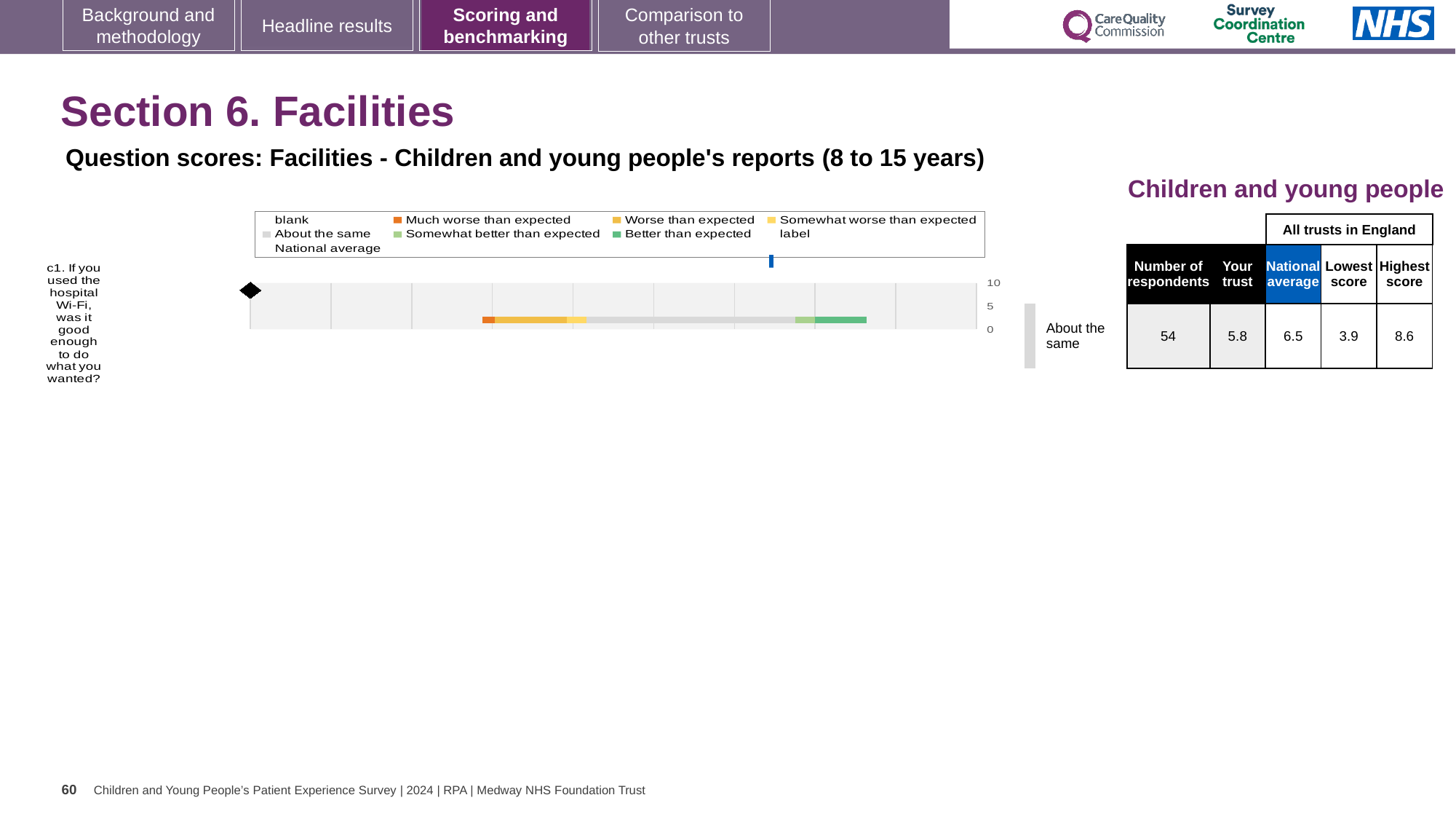
According to the table beside the chart, what is the lowest score among all trusts in England for question c1? 3.9 What is the difference between the highest score and the lowest score for question c1? 4.7 Which is larger for question c1: the 'Your trust' score or the national average? National average How many respondents answered question c1 about hospital Wi-Fi? 54 What kind of chart is used to show the question score for c1 on this slide? bar chart According to the table beside the chart, what is the 'Your trust' score for question c1 about hospital Wi-Fi? 5.8 In the chart legend, which colour represents 'Better than expected'? green According to the table beside the chart, what is the national average score for question c1? 6.5 What benchmark category is the trust's score for question c1 placed in? About the same How many survey questions are plotted in the chart on this slide? 1 In the chart legend, which colour represents 'Much worse than expected'? orange According to the table beside the chart, what is the highest score among all trusts in England for question c1? 8.6